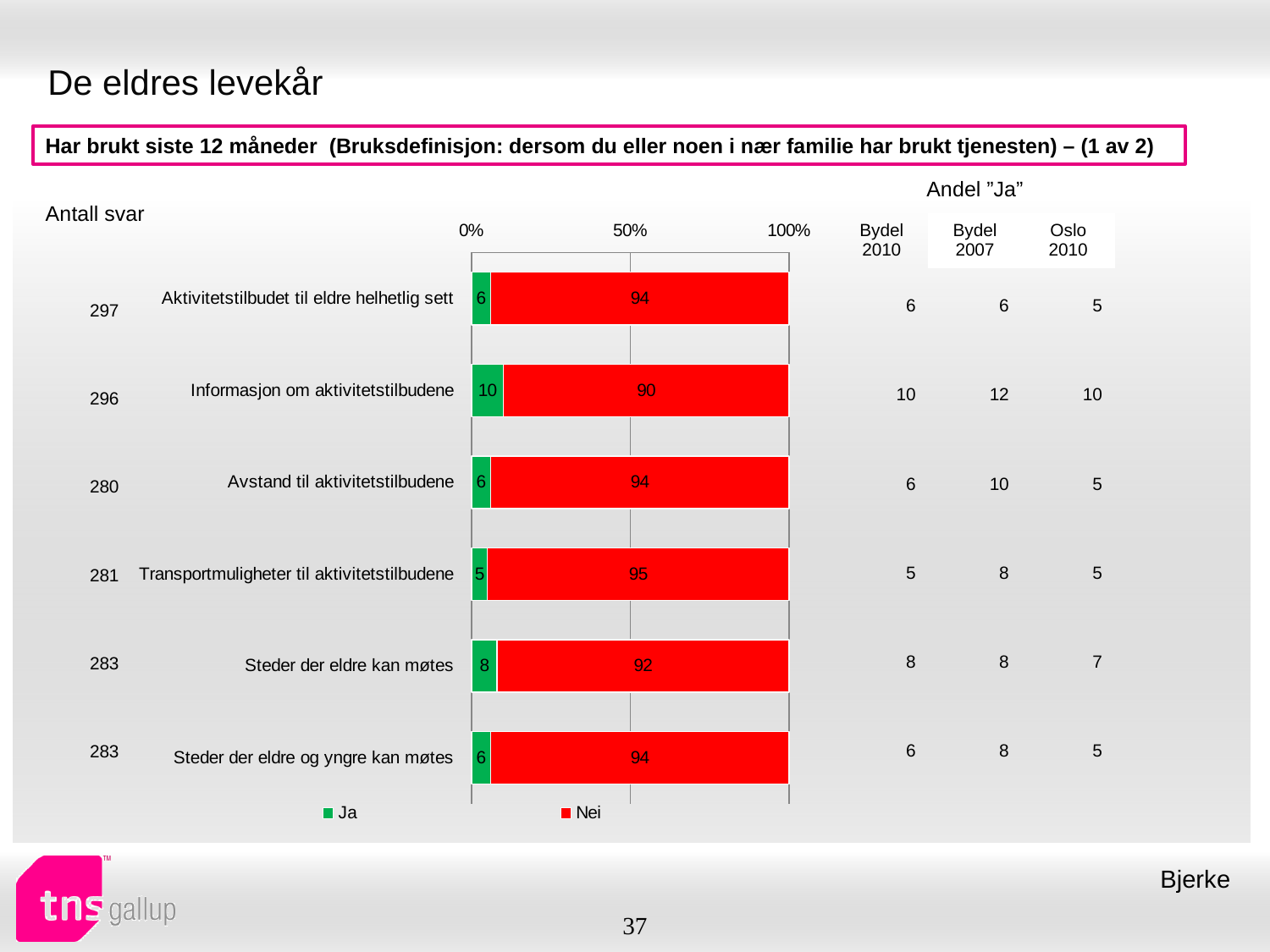
How many series does the legend list? 2 What is the "Ja" value for Informasjon om aktivitetstilbudene? 10 What is the "Nei" value for Transportmuligheter til aktivitetstilbudene? 95 Which category has the highest "Ja" value? Informasjon om aktivitetstilbudene What is the difference between the "Nei" values for Transportmuligheter til aktivitetstilbudene and Informasjon om aktivitetstilbudene? 5 What is the total of the stacked bar for Steder der eldre kan møtes? 100 How many categories are shown in the chart? 6 What is the "Ja" value for Steder der eldre kan møtes? 8 Which series is shown in red in the chart? Nei Which is larger: the "Ja" value for Steder der eldre kan møtes or the "Ja" value for Avstand til aktivitetstilbudene? Steder der eldre kan møtes Which category has the lowest "Ja" value? Transportmuligheter til aktivitetstilbudene What kind of chart is shown on the slide? Stacked bar chart